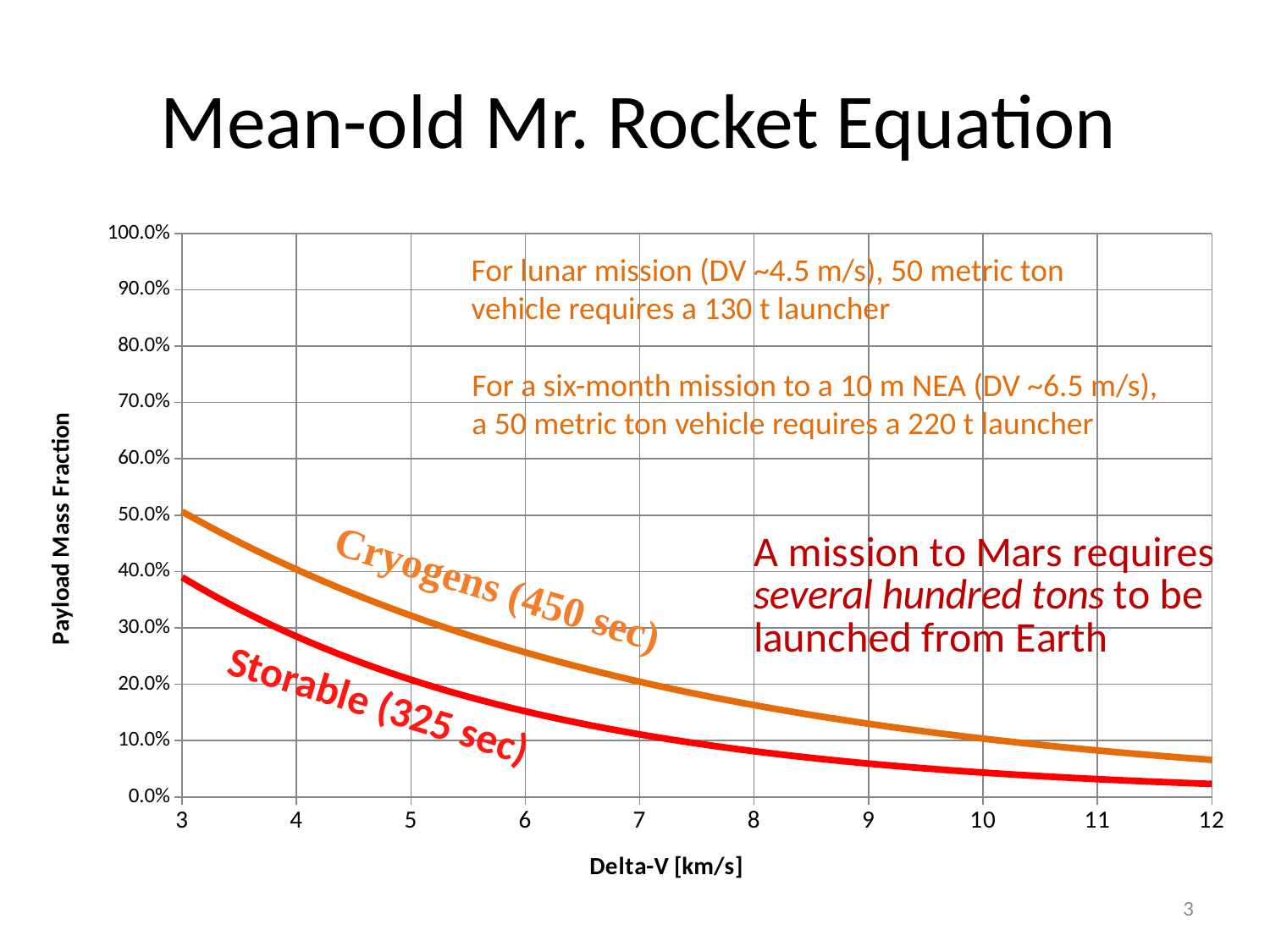
Is the payload mass fraction for Storable (325 sec) at a Delta-V of 6 km/s greater or less than 20.0%? less How many curves are plotted on the chart? 2 What is the title of the y axis? Payload Mass Fraction Is the payload mass fraction for Cryogens (450 sec) at a Delta-V of 5 km/s greater or less than 30.0%? greater What kind of chart is shown on the slide? line chart Does the Storable (325 sec) curve rise or fall as Delta-V increases? fall Does the Cryogens (450 sec) curve rise or fall as Delta-V increases? fall What is the title of the x axis? Delta-V [km/s] Is the payload mass fraction for Cryogens (450 sec) at a Delta-V of 12 km/s greater or less than 10.0%? less At a Delta-V of 8 km/s, which curve has the higher payload mass fraction, Cryogens (450 sec) or Storable (325 sec)? Cryogens (450 sec)